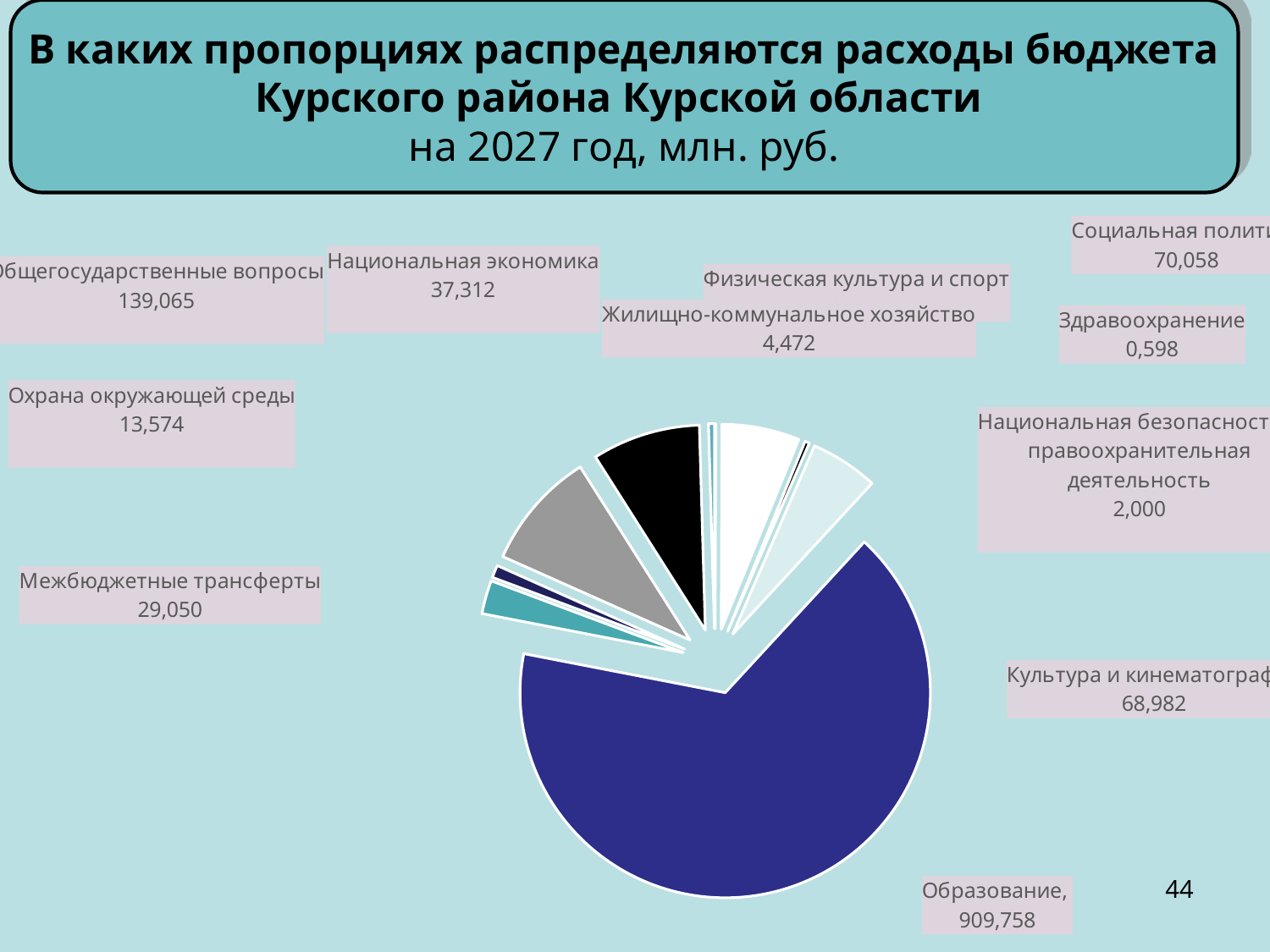
What is the value for Межбюджетные трансферты? 29,050 Which labelled category has the smallest value? Здравоохранение What kind of chart is shown on the slide? Pie chart For which year does the chart show the budget expenditure distribution? 2027 What is the value for Здравоохранение? 0,598 What is the difference between Общегосударственные вопросы and Национальная экономика? 101,753 What is the difference between Межбюджетные трансферты and Охрана окружающей среды? 15,476 What is the value for Общегосударственные вопросы? 139,065 What is the value for Образование? 909,758 Which category has the largest value? Образование What is the value for Национальная экономика? 37,312 Which is larger, Жилищно-коммунальное хозяйство or Национальная безопасность и правоохранительная деятельность? Жилищно-коммунальное хозяйство